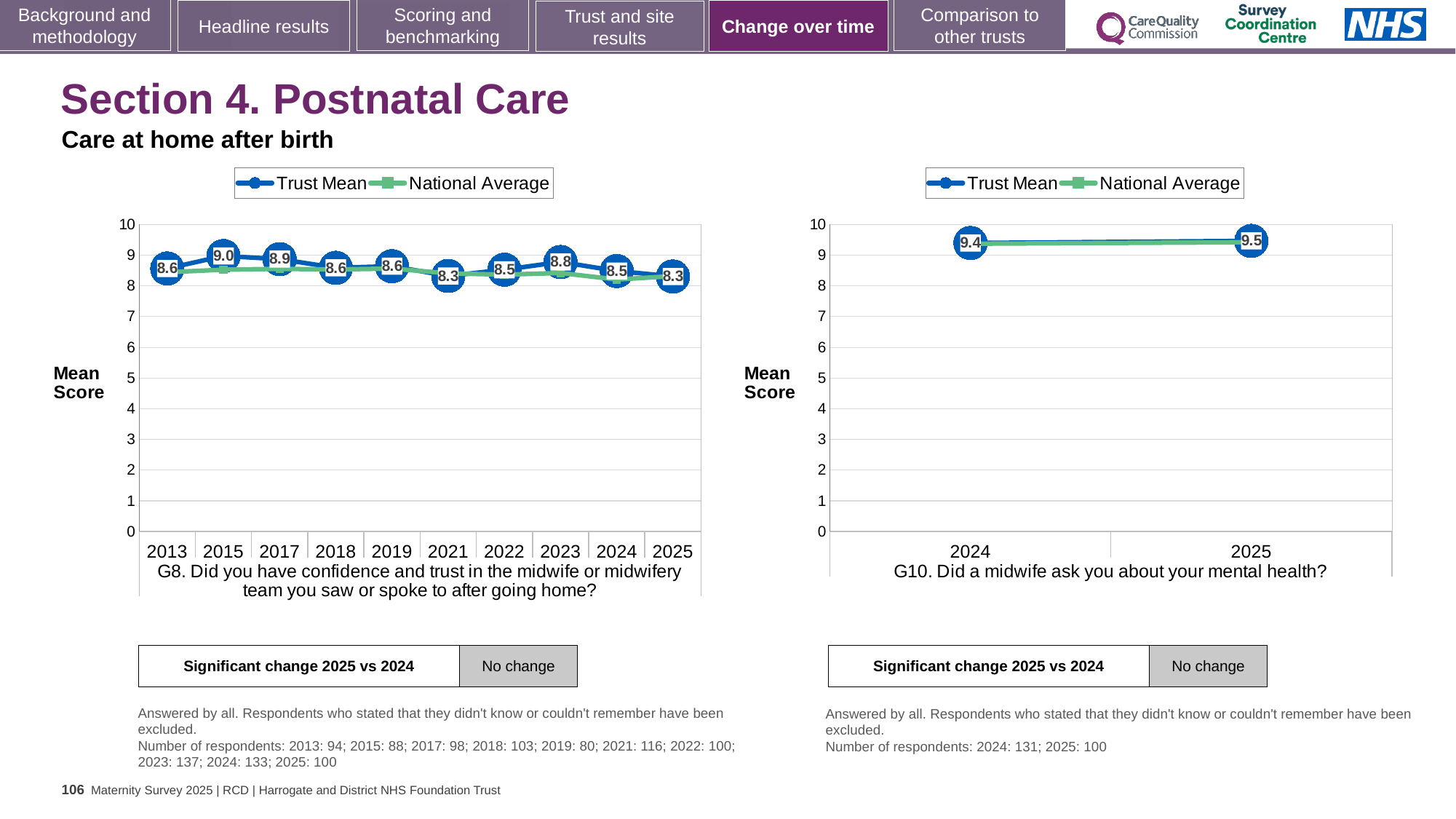
What type of chart is the G10 chart? Line chart On the G8 chart, is the National Average for 2013 greater or less than 8? greater On the G8 chart, what is the Trust Mean for 2015? 9.0 How many series does the legend of the G10 chart list? 2 On the G8 chart, is the Trust Mean higher in 2023 or in 2024? 2023 On the G10 chart, what is the Trust Mean for 2024? 9.4 On the G8 chart, what is the Trust Mean for 2025? 8.3 On the G8 chart, what is the lowest Trust Mean value shown? 8.3 On the G8 chart, what is the difference between the Trust Mean in 2015 and in 2025? 0.7 How many years are plotted on the G8 chart? 10 On the G8 chart, which year has the highest Trust Mean? 2015 On the G10 chart, what is the difference between the Trust Mean in 2025 and in 2024? 0.1